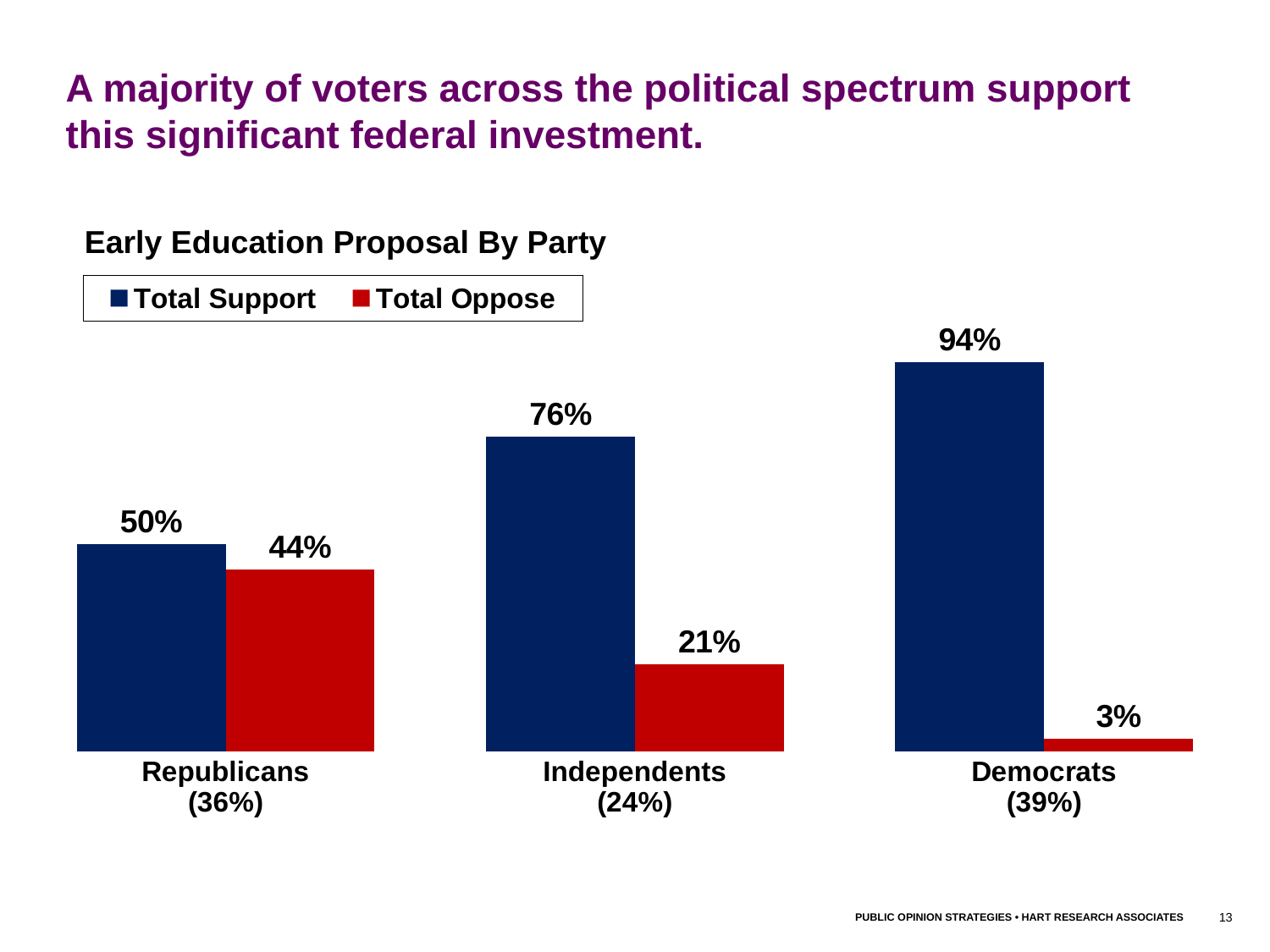
What is the difference between Total Support for Democrats and Total Support for Independents? 18% Which party group has the highest Total Support value? Democrats Which is larger: Total Oppose for Republicans or Total Oppose for Independents? Total Oppose for Republicans What kind of chart is shown on the slide? Bar chart What is the Total Support value for Independents? 76% How many party groups are shown on the x axis? 3 Which party group has the lowest Total Oppose value? Democrats How many series does the legend list? 2 What is the title of the chart? Early Education Proposal By Party What is the difference between Total Support and Total Oppose for Republicans? 6% What is the Total Oppose value for Democrats? 3% What is the Total Oppose value for Republicans? 44%